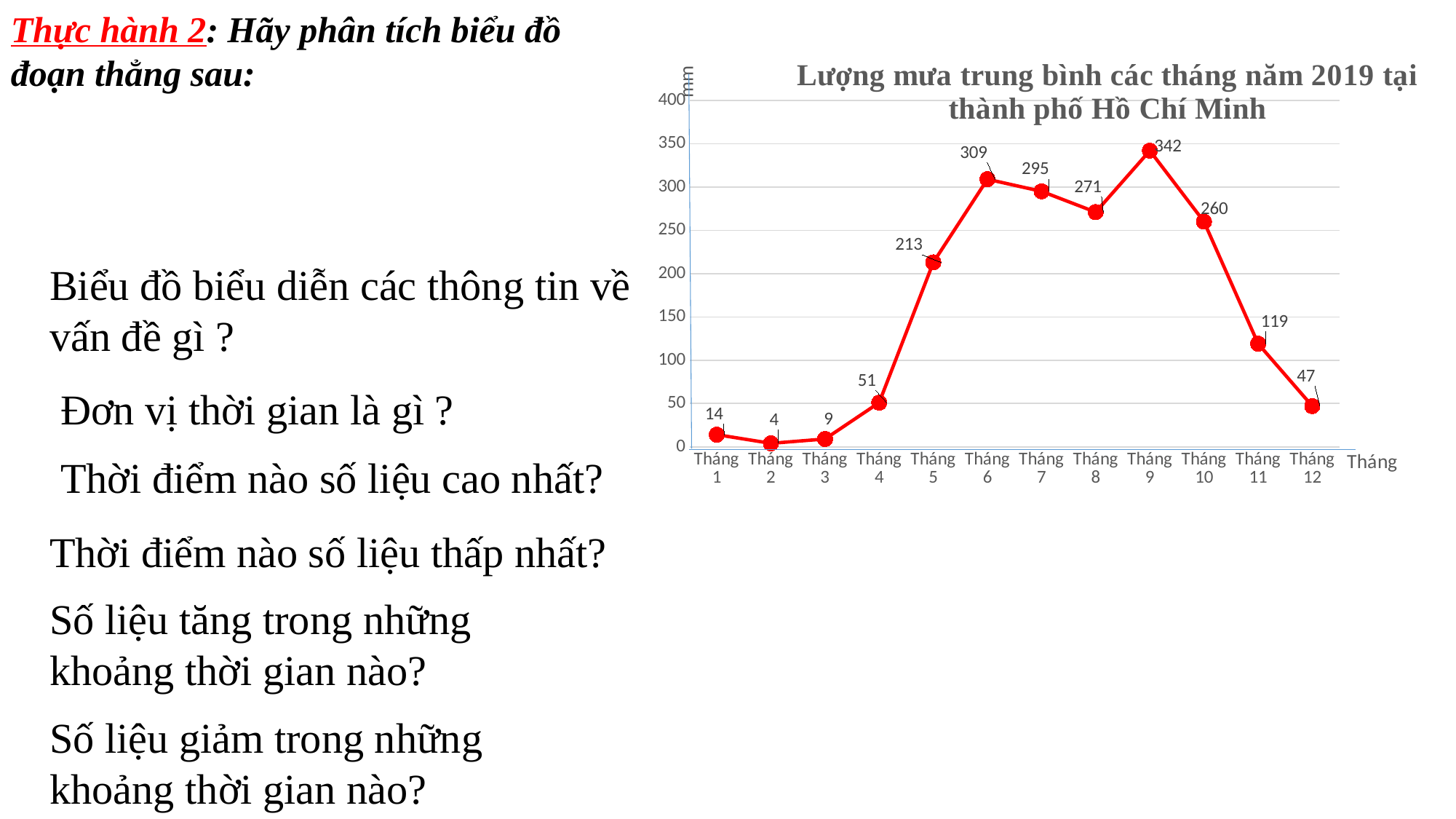
Does the rainfall rise or fall from Tháng 9 to Tháng 12? Fall How many months are plotted on the chart? 12 Which month has the lowest average rainfall? Tháng 2 Which month has more rainfall, Tháng 7 or Tháng 8? Tháng 7 What kind of chart is shown on the slide? Line chart What is the title of the chart? Lượng mưa trung bình các tháng năm 2019 tại thành phố Hồ Chí Minh What is the average rainfall for Tháng 11? 119 What is the average rainfall for Tháng 6? 309 What is the difference in rainfall between Tháng 9 and Tháng 10? 82 What is the average rainfall for Tháng 2? 4 Which month has the highest average rainfall? Tháng 9 What is the difference in rainfall between Tháng 5 and Tháng 4? 162